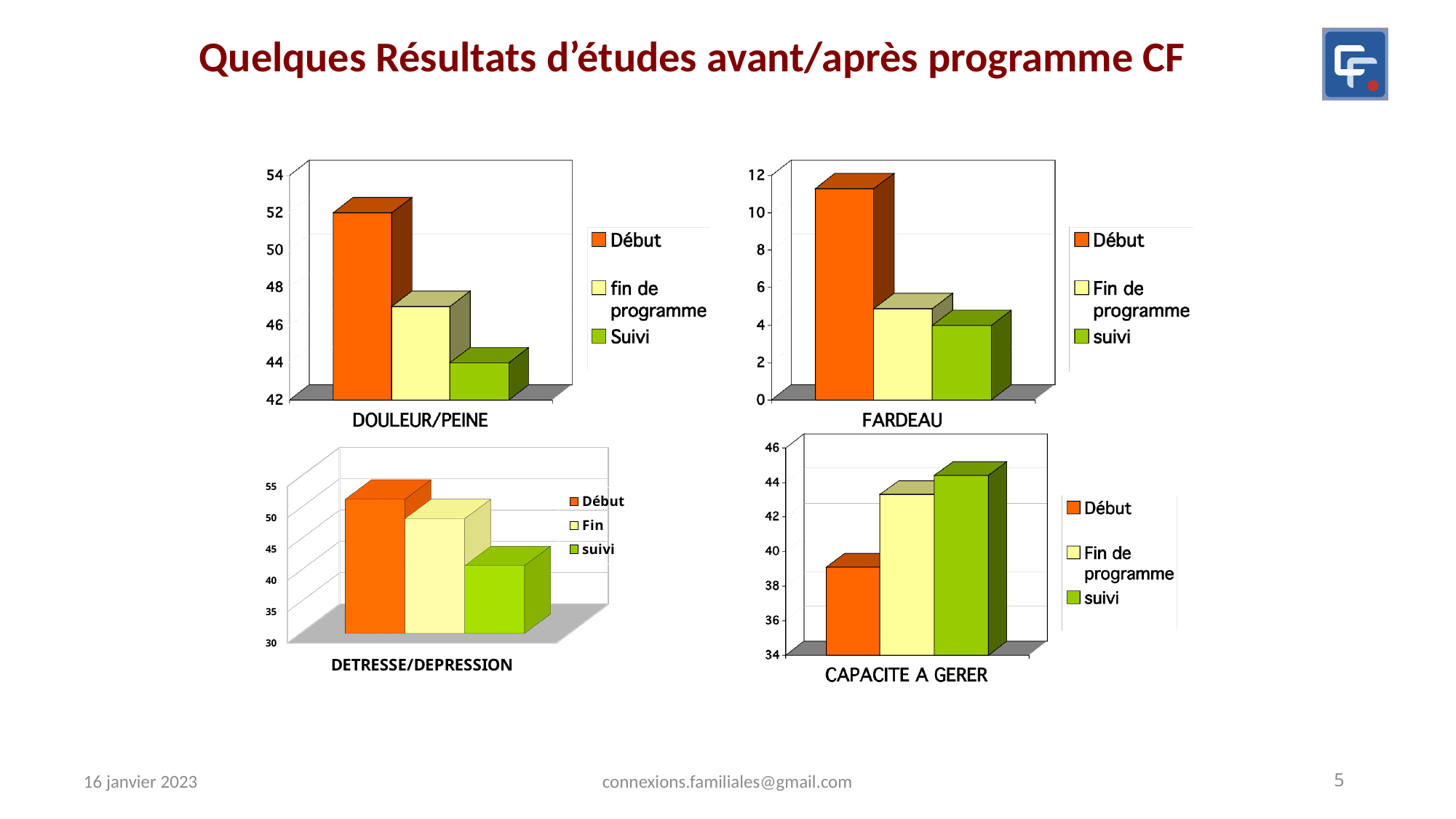
In the CAPACITE A GERER chart, do the values rise or fall from Début to suivi? rise In the CAPACITE A GERER chart, is the value for Début greater or less than 40? less In the FARDEAU chart, is the value for Début greater or less than 10? greater What kind of chart is the DOULEUR/PEINE chart? bar chart In the DETRESSE/DEPRESSION chart, which is larger, Début or suivi? Début In the FARDEAU chart, is the value for suivi greater or less than 6? less How many charts are shown on the slide? 4 In the DOULEUR/PEINE chart, which series has the lowest value? Suivi In the CAPACITE A GERER chart, which series has the highest value? suivi How many series does the legend of the FARDEAU chart list? 3 In the DETRESSE/DEPRESSION chart, do the values rise or fall from Début to suivi? fall In the DOULEUR/PEINE chart, which series has the highest value? Début